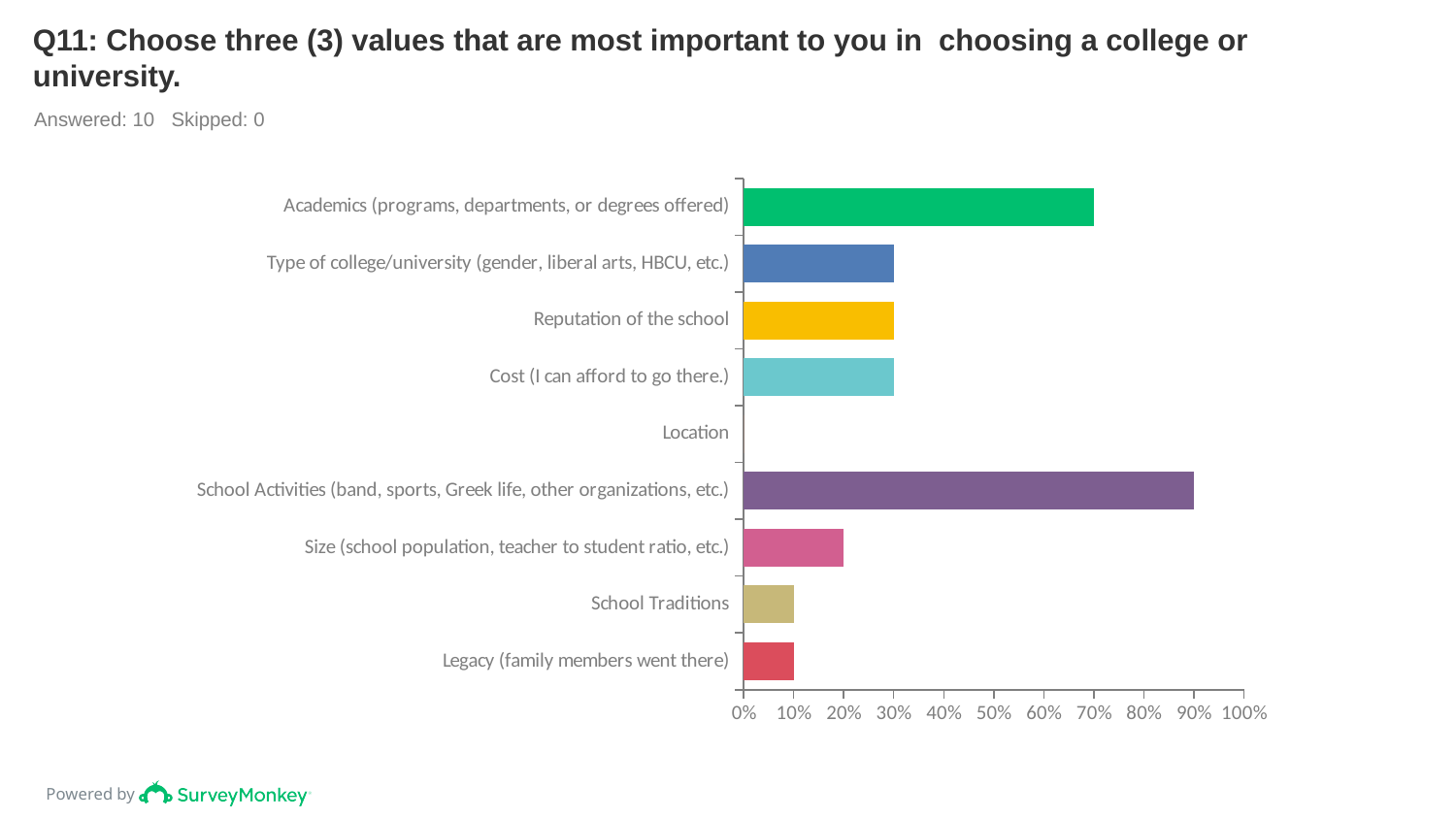
Which is larger, the value for Reputation of the school or the value for Legacy (family members went there)? Reputation of the school What is the value for Size (school population, teacher to student ratio, etc.)? 20% How many respondents answered this question according to the slide? 10 What type of chart is shown on the slide? Bar chart What is the difference between the values for School Activities and Academics? 20% Which category has the lowest value? Location What is the value for School Traditions? 10% Which category has the highest value? School Activities (band, sports, Greek life, other organizations, etc.) What is the value for School Activities (band, sports, Greek life, other organizations, etc.)? 90% What is the value for Academics (programs, departments, or degrees offered)? 70% Is the value for Cost (I can afford to go there.) greater or less than 50%? less How many categories are shown in the chart? 9